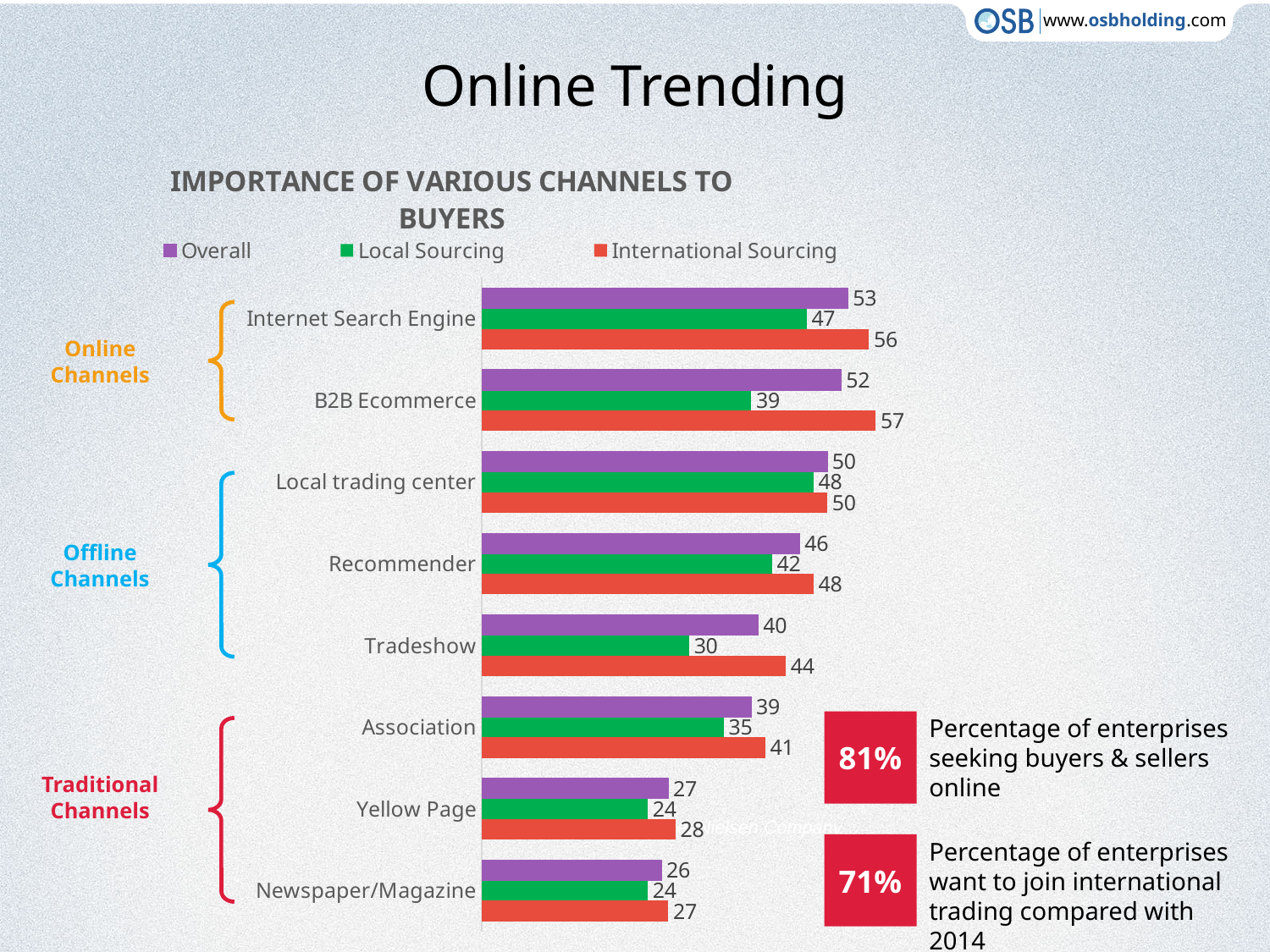
How many categories are shown on the chart? 8 Which colour represents the Local Sourcing series? Green What kind of chart is shown on the slide? Bar chart What is the Overall value for Internet Search Engine? 53 Which is larger for Recommender: the Overall value or the International Sourcing value? International Sourcing What is the Local Sourcing value for B2B Ecommerce? 39 What is the title of the chart? IMPORTANCE OF VARIOUS CHANNELS TO BUYERS How many series does the legend list? 3 Which category has the lowest Overall value? Newspaper/Magazine What is the difference between the International Sourcing and Local Sourcing values for B2B Ecommerce? 18 Which category has the highest International Sourcing value? B2B Ecommerce What is the International Sourcing value for Tradeshow? 44